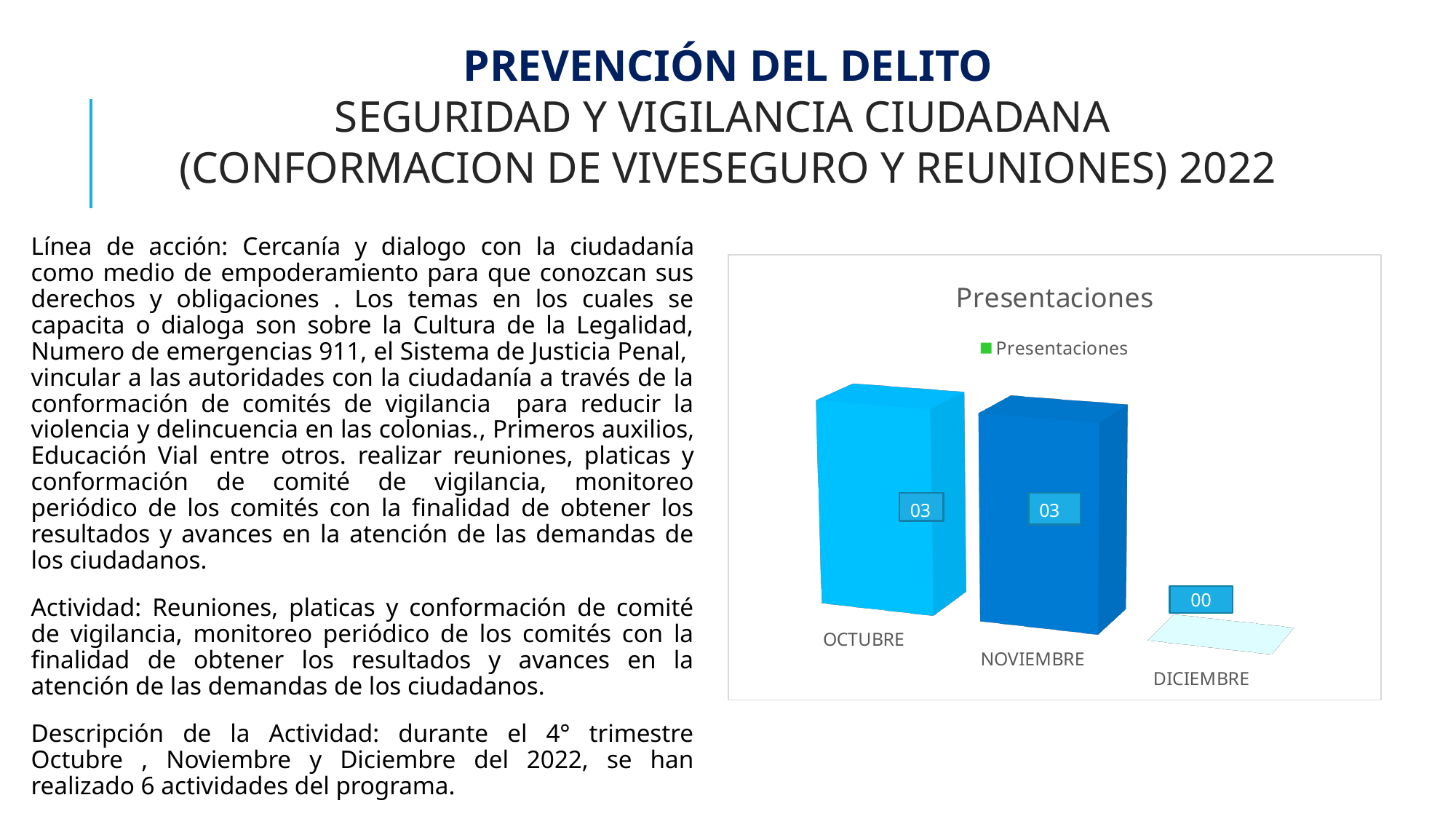
What is the difference between the values for OCTUBRE and DICIEMBRE? 3 How many series does the legend of the chart list? 1 Which month has the lowest value in the Presentaciones chart? DICIEMBRE What is the value for NOVIEMBRE in the Presentaciones chart? 03 What is the title of the chart? Presentaciones Do the values rise or fall from NOVIEMBRE to DICIEMBRE? Fall What is the value for OCTUBRE in the Presentaciones chart? 03 What is the total of the values for OCTUBRE, NOVIEMBRE and DICIEMBRE? 6 What is the value for DICIEMBRE in the Presentaciones chart? 00 What kind of chart is shown on the slide? Bar chart How many categories are shown in the Presentaciones chart? 3 Which is larger, the value for NOVIEMBRE or the value for DICIEMBRE? NOVIEMBRE